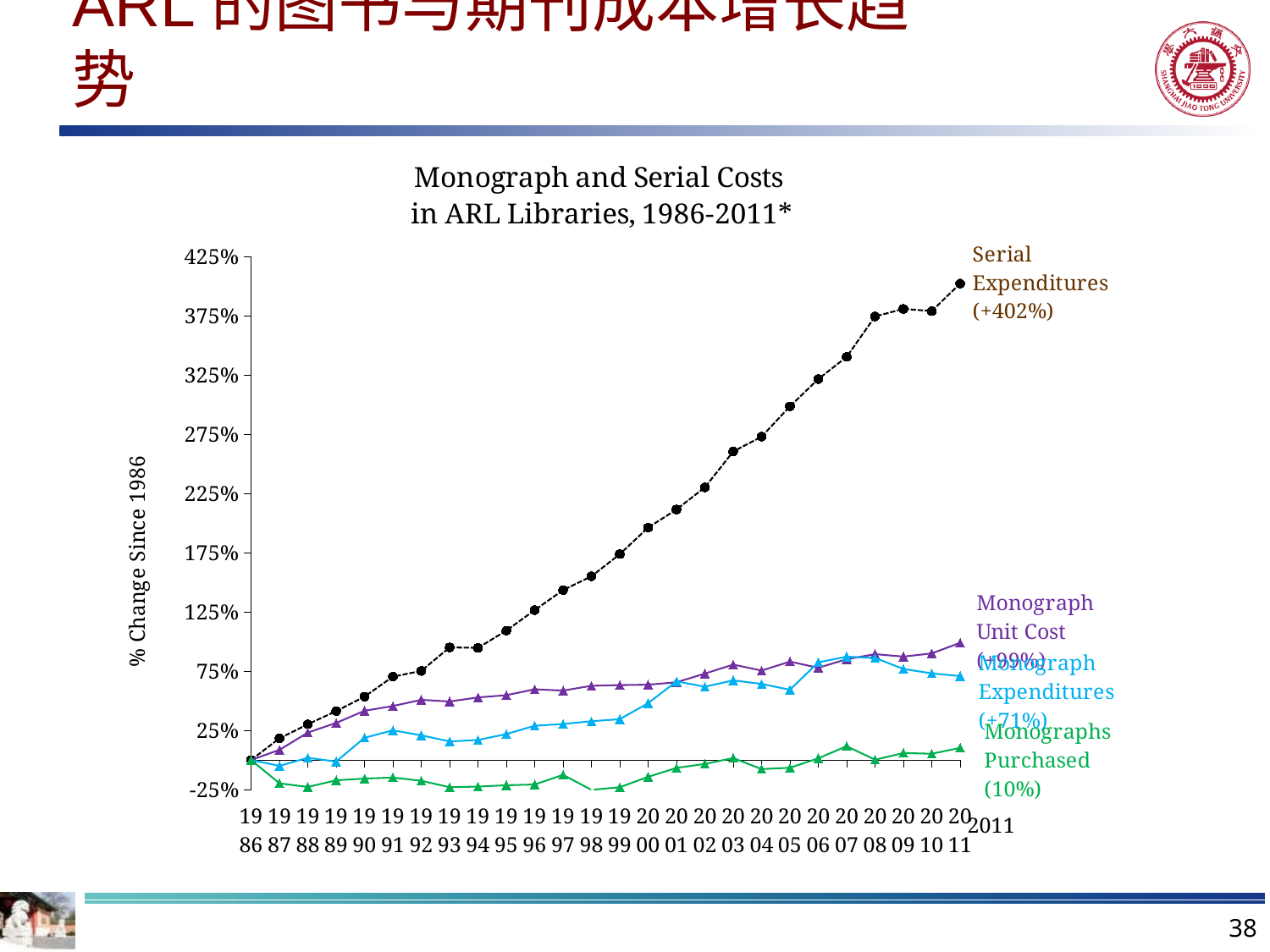
What kind of chart is shown on the slide? line chart What is the difference between the 2011 values for Serial Expenditures and Monograph Unit Cost? 303% Is the value for Serial Expenditures in 2005 greater or less than 275%? greater What is the percent change since 1986 for Serial Expenditures in 2011? +402% What is the percent change since 1986 for Monograph Expenditures in 2011? +71% Which series has the highest value in 2011? Serial Expenditures Does the Serial Expenditures line generally rise or fall from 1986 to 2011? rise What is the percent change since 1986 for Monograph Unit Cost in 2011? +99% Which series has the lowest value in 2011? Monographs Purchased What is the percent change since 1986 for Monographs Purchased in 2011? 10% How many data series are plotted on the chart? 4 In 2011, which is larger: Monograph Unit Cost or Monograph Expenditures? Monograph Unit Cost